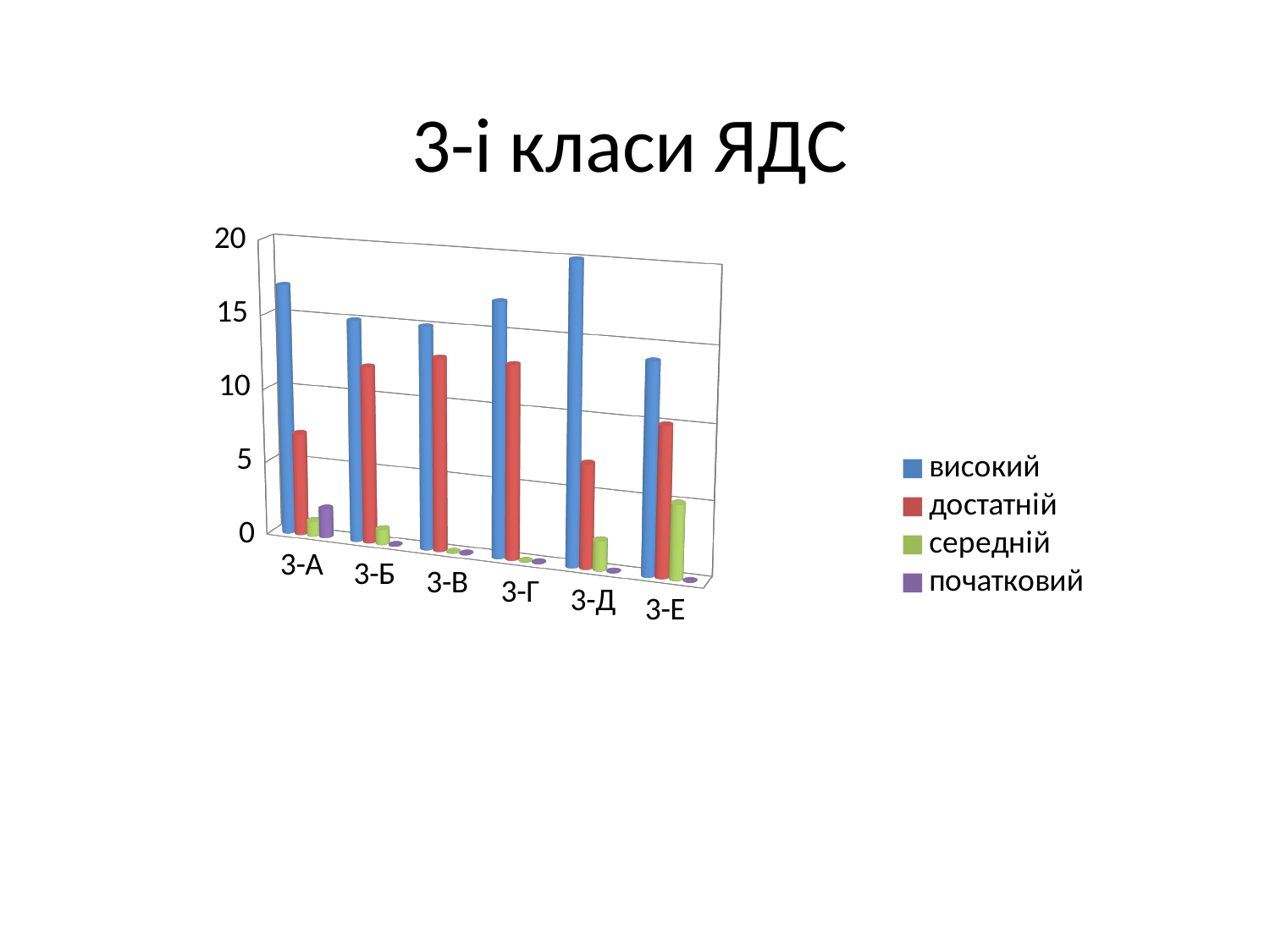
How many series does the legend list? 4 In class 3-Е, which is larger: середній or початковий? середній What is the title of the chart? 3-і класи ЯДС In class 3-А, which is larger: високий or достатній? високий Which class has the highest value for високий? 3-Д Which class has the highest value for середній? 3-Е What kind of chart is shown on the slide? bar chart Is the value for високий in 3-Д greater or less than 15? greater Is the value for високий in 3-Б greater or less than 10? greater Which class has the lowest value for високий? 3-Е Is the value for достатній in 3-А greater or less than 10? less How many classes (categories) are shown on the x axis? 6